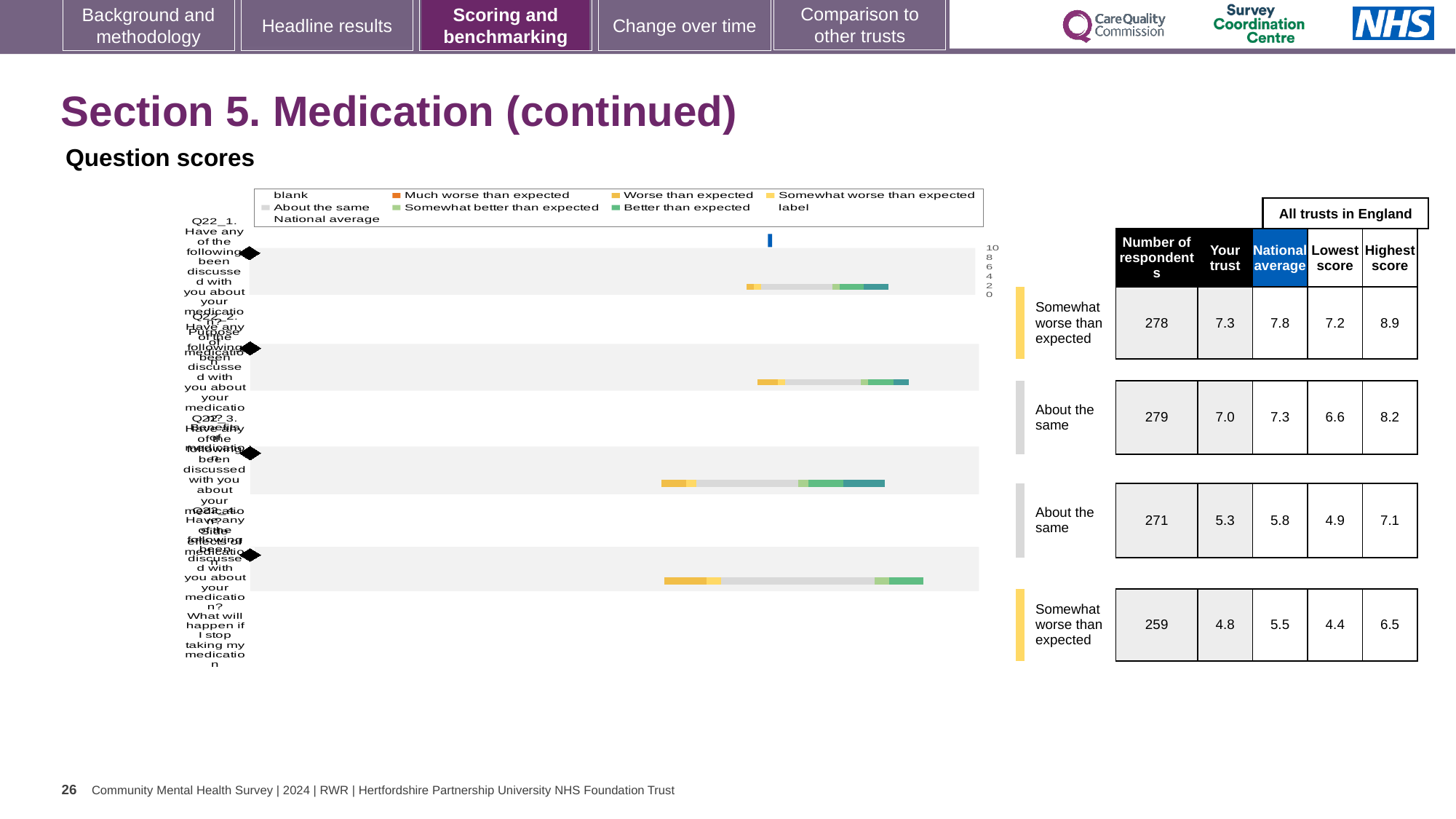
What kind of chart is used to show the question scores? Bar chart How many question bars are plotted in the chart? 4 For the first question row, what is the difference between the national average and the 'Your trust' score? 0.5 Which question row has the highest 'Your trust' score in the table? The first row (7.3) For the third question row, which is larger: the 'Your trust' score or the national average? National average In the table, what is the number of respondents for the first question row? 278 In the table, what is the national average for the fourth (bottom) question row? 5.5 In the table, what is the 'Your trust' score for the second question row? 7.0 Which question row has the lowest 'Your trust' score in the table? The fourth row (4.8) What is the difference in number of respondents between the first and fourth question rows? 19 In the table, what is the highest score for the third question row? 7.1 What benchmark category is shown for the fourth (bottom) question row? Somewhat worse than expected